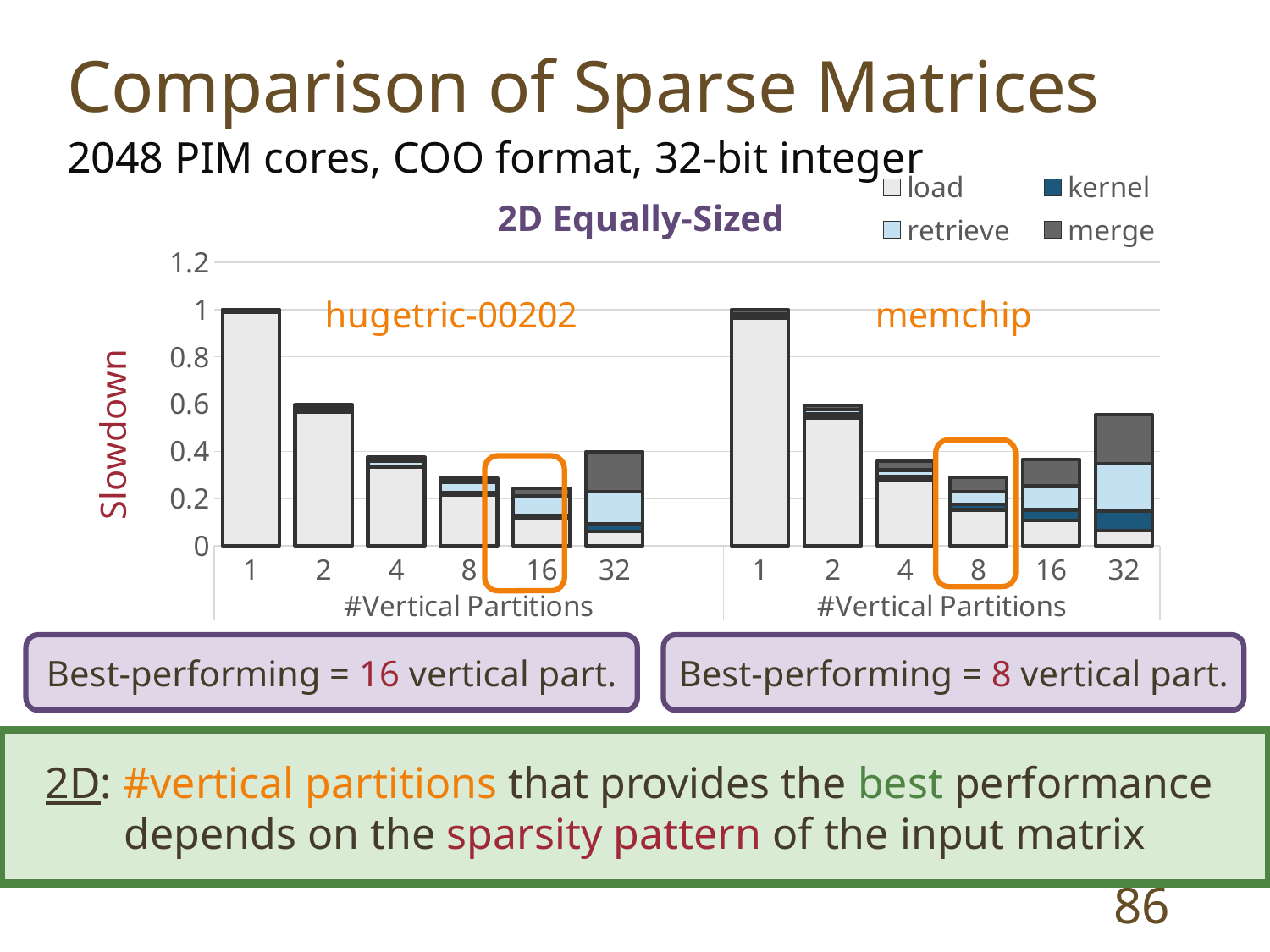
How many series does the legend list? 4 What kind of chart is shown on the slide? bar chart How many #Vertical Partitions categories are plotted for the hugetric-00202 matrix? 6 For the hugetric-00202 matrix, which number of vertical partitions has the lowest slowdown? 16 For the hugetric-00202 matrix, is the total slowdown at 16 vertical partitions greater or less than 0.2? greater What are the series listed in the legend? load, kernel, retrieve, merge What is the title of the chart? 2D Equally-Sized For the memchip matrix, which has the larger total slowdown: 16 or 32 vertical partitions? 32 For the memchip matrix, is the total slowdown at 32 vertical partitions greater or less than 0.4? greater For the memchip matrix, which number of vertical partitions has the lowest slowdown? 8 For the memchip matrix, which number of vertical partitions has the highest slowdown? 1 For the hugetric-00202 matrix, which number of vertical partitions has the highest slowdown? 1